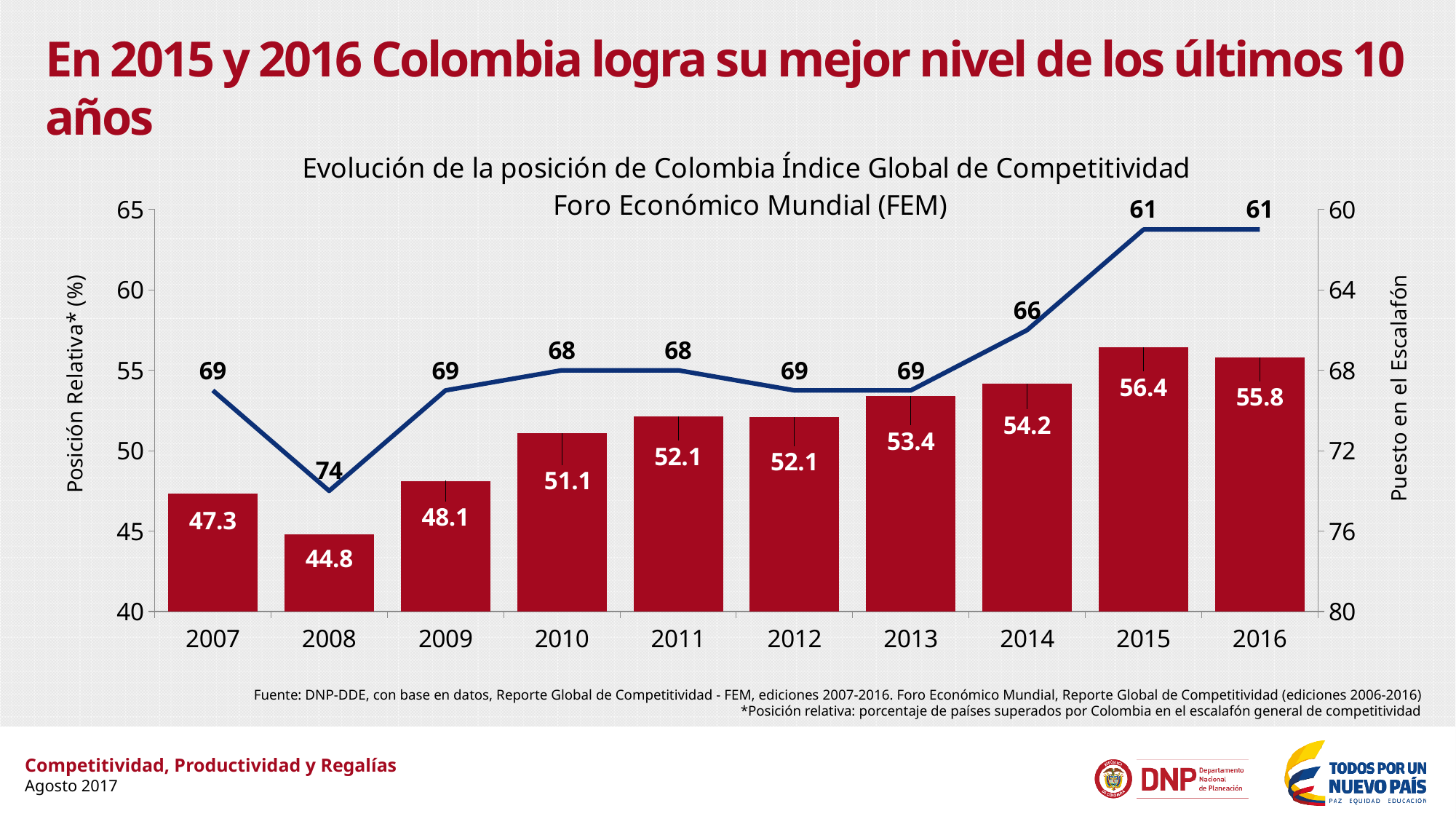
What kind of chart is used to show the Posición Relativa (%) values? Bar chart What is the difference between the Posición Relativa (%) values for 2015 and 2016? 0.6 What is the difference between the Puesto en el Escalafón values for 2014 and 2015? 5 Which year has the highest Puesto en el Escalafón value on the line? 2008 Do the Posición Relativa (%) bars generally rise or fall from 2008 to 2015? Rise Which year has the highest Posición Relativa (%) bar? 2015 What is the Posición Relativa (%) value shown for 2015? 56.4 How many years are shown on the x axis? 10 What Puesto en el Escalafón value is labelled on the line for 2008? 74 Which year has the lowest Posición Relativa (%) bar? 2008 What is the Posición Relativa (%) value shown for 2012? 52.1 Which year has a larger Posición Relativa (%) value, 2009 or 2010? 2010